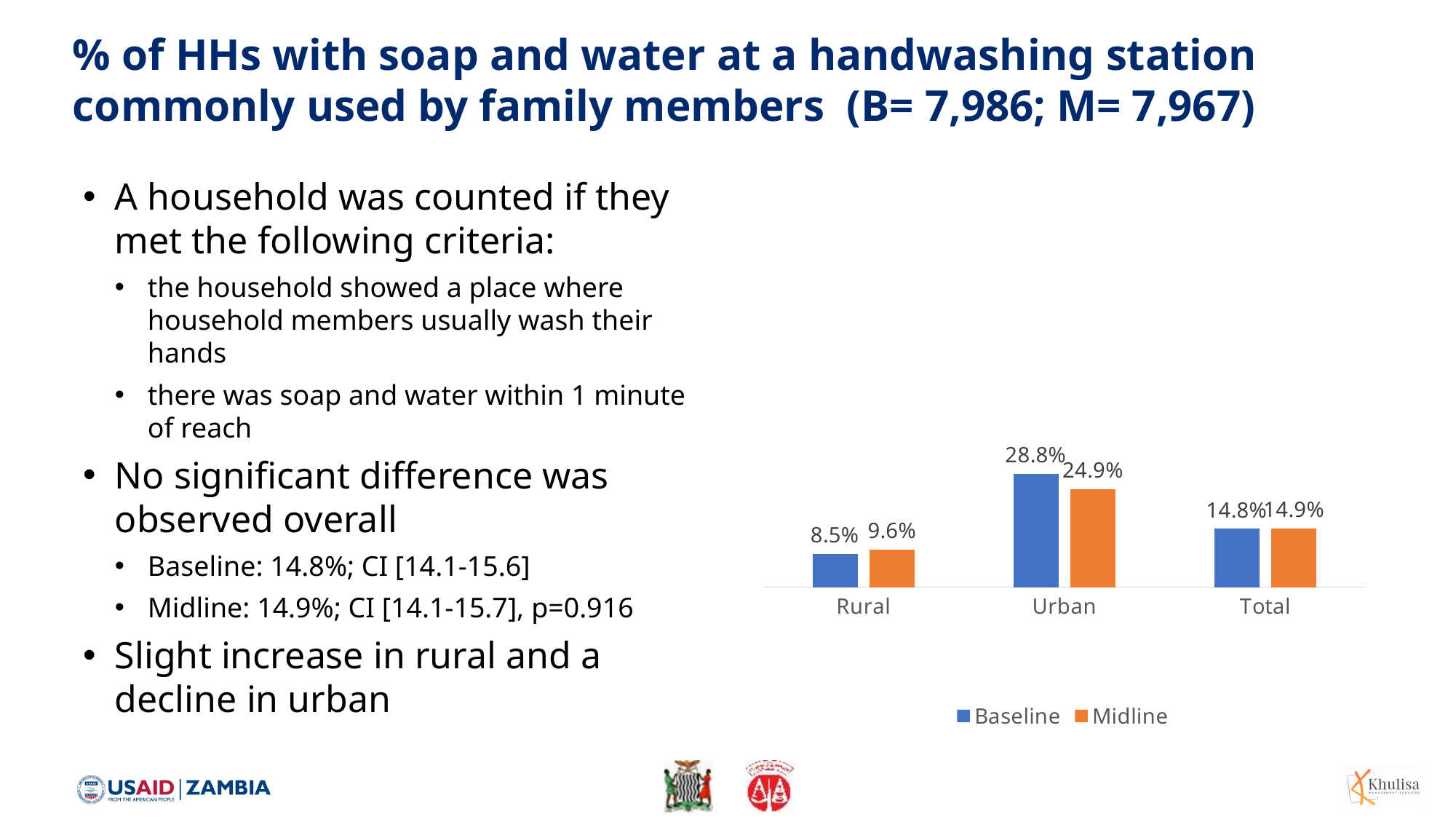
What is the Baseline value for Urban? 28.8% How many categories are shown on the x axis? 3 Which category has the highest Baseline value? Urban What kind of chart is shown on the slide? Bar chart Which is larger for Rural, the Baseline value or the Midline value? Midline What is the Baseline value for Rural? 8.5% How many series does the legend list? 2 What is the Midline value for Total? 14.9% What is the difference between the Baseline and Midline values for Urban? 3.9% What is the Midline value for Urban? 24.9% What is the difference between the Midline and Baseline values for Rural? 1.1% Which category has the lowest Midline value? Rural